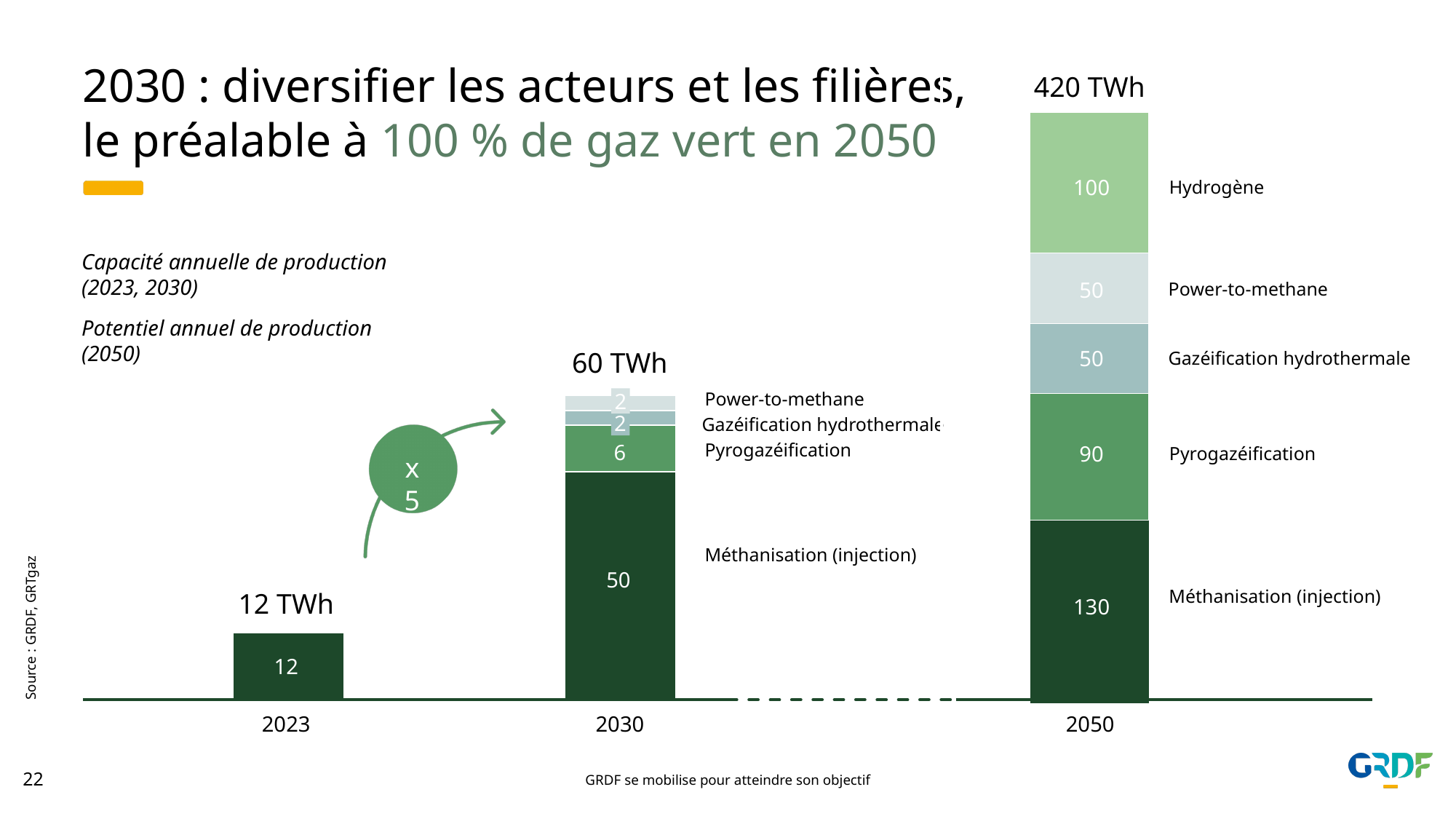
How many years (bars) are shown on the x axis of the chart? 3 What is the total annual production shown for 2030? 60 TWh What is the total annual production potential shown for 2050? 420 TWh What value is shown for Pyrogazéification in 2030? 6 What type of chart is shown on the slide? Stacked bar chart Which year has the lowest total production in the chart? 2023 What value is shown for Power-to-methane in 2030? 2 Which year has the highest total production in the chart? 2050 What value is shown for Méthanisation (injection) in 2050? 130 Which is larger in 2050: Pyrogazéification or Gazéification hydrothermale? Pyrogazéification What is the difference between the Méthanisation (injection) values for 2050 and 2030? 80 What value is shown for Hydrogène in 2050? 100